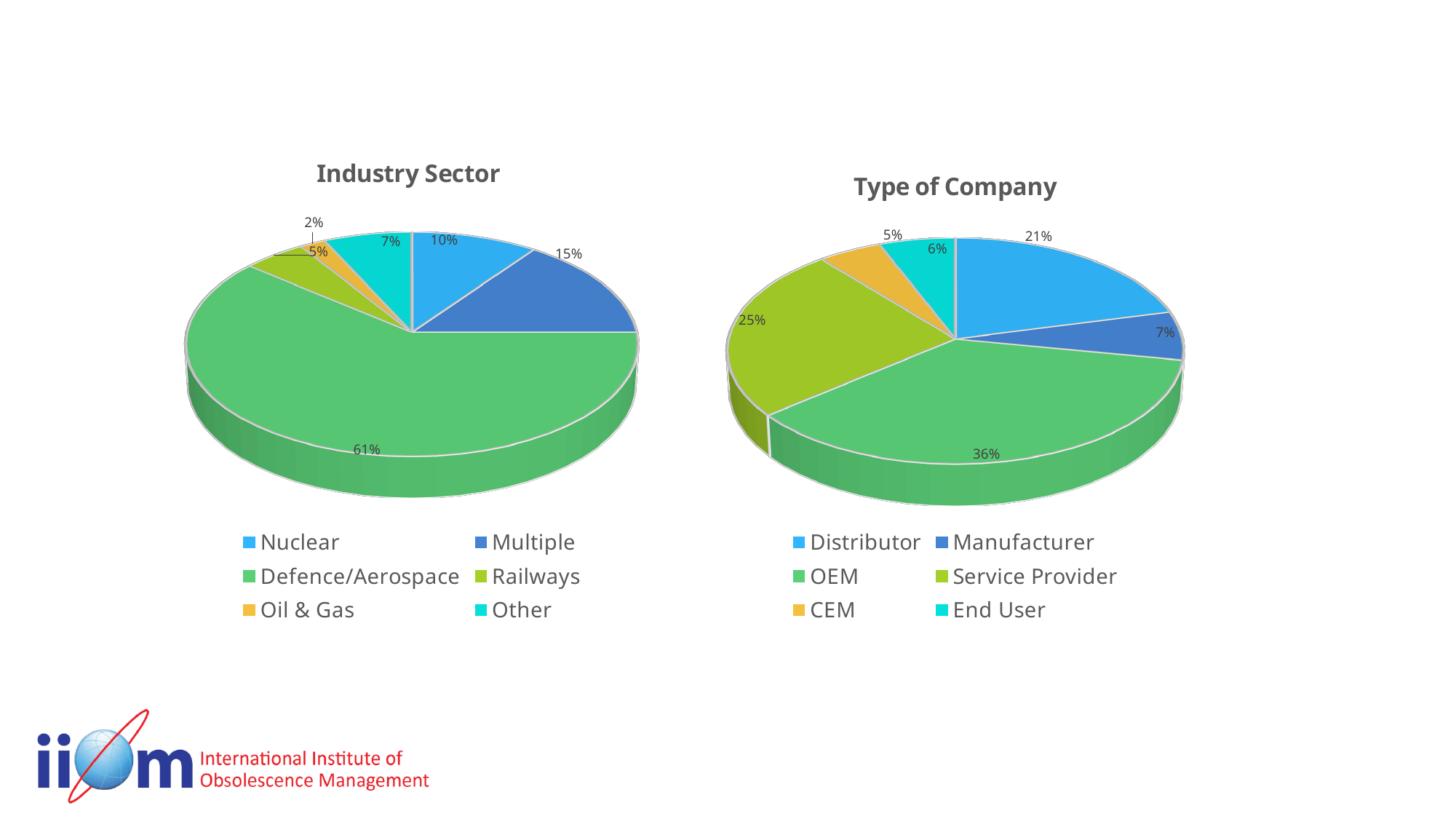
In the Industry Sector chart, what share does Defence/Aerospace have? 61% In the Type of Company chart, what percentage is Service Provider? 25% In the Industry Sector chart, which is larger, Other or Railways? Other What kind of chart is the Industry Sector chart? Pie chart In the Type of Company chart, what is the difference between Distributor and Manufacturer? 14% In the Industry Sector chart, what percentage is Nuclear? 10% In the Type of Company chart, what share does OEM have? 36% In the Industry Sector chart, which sector has the largest slice? Defence/Aerospace In the Industry Sector chart, which sector has the smallest slice? Oil & Gas How many categories does the Type of Company chart's legend list? 6 In the Industry Sector chart, what is the difference between Multiple and Nuclear? 5% In the Type of Company chart, which company type has the smallest slice? CEM